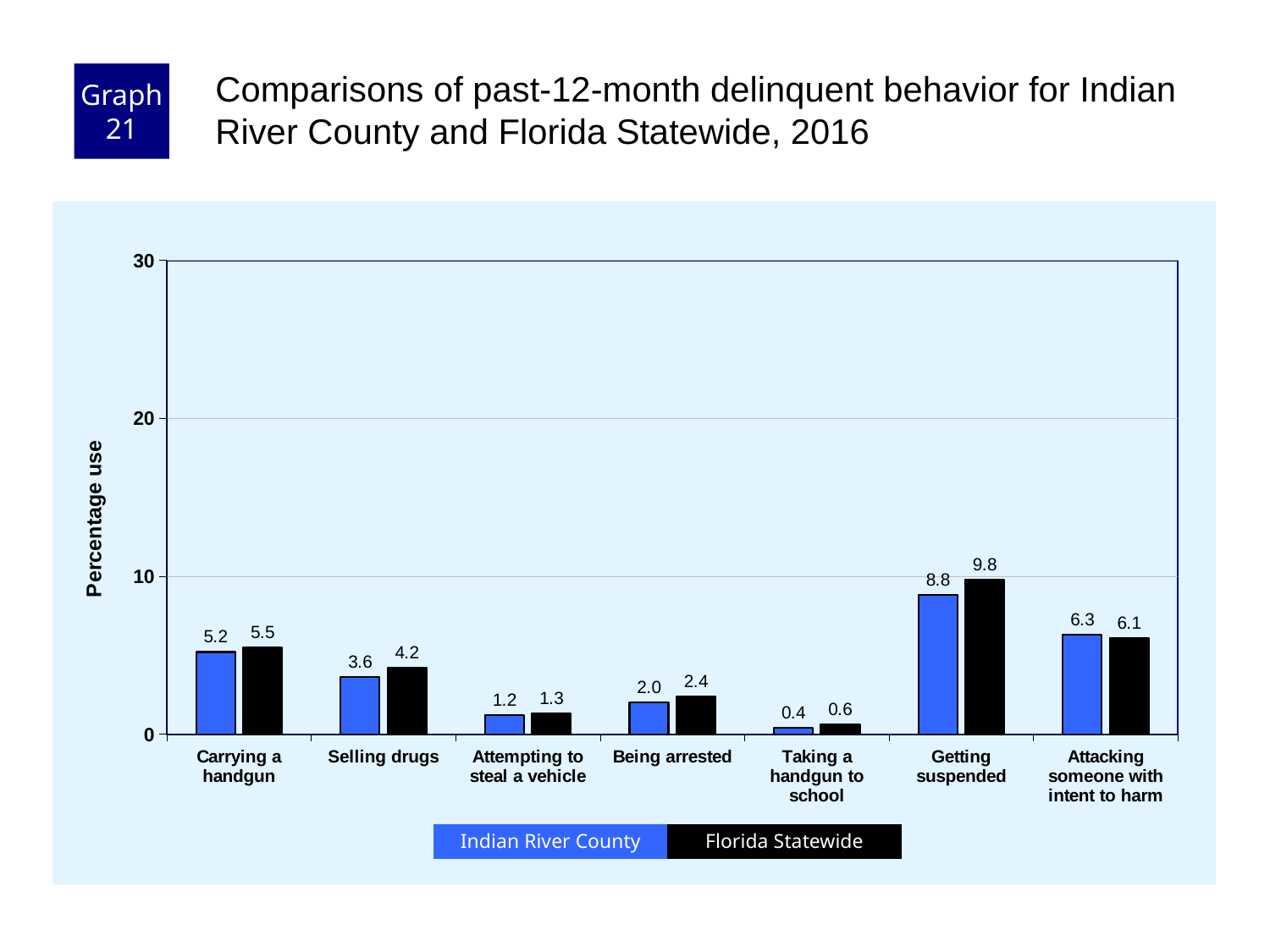
What is the Indian River County value for Getting suspended? 8.8 For Attacking someone with intent to harm, which is larger: Indian River County or Florida Statewide? Indian River County How many behavior categories are shown on the x axis? 7 What kind of chart is shown on the slide? bar chart Which category has the highest Florida Statewide value? Getting suspended Which category has the lowest Indian River County value? Taking a handgun to school Is the Florida Statewide value for Getting suspended greater or less than 10? less How many series does the legend list? 2 What is the Indian River County value for Taking a handgun to school? 0.4 What is the Florida Statewide value for Selling drugs? 4.2 What is the label of the y axis? Percentage use What is the difference between the Florida Statewide and Indian River County values for Getting suspended? 1.0